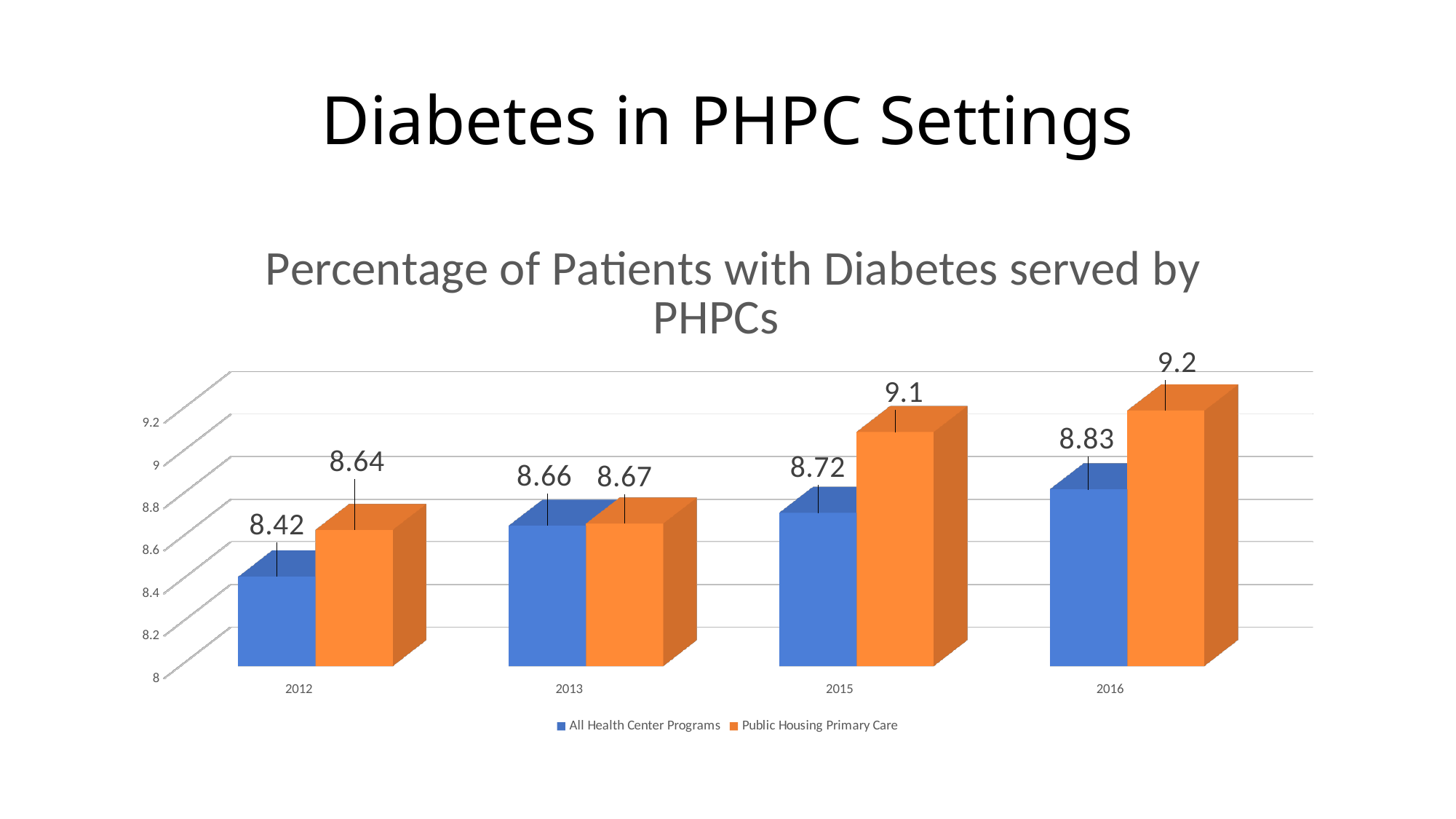
What is the title of the chart? Percentage of Patients with Diabetes served by PHPCs What is the value for Public Housing Primary Care in 2016? 9.2 Do the values for Public Housing Primary Care rise or fall from 2012 to 2016? rise What kind of chart is this? bar chart What is the value for All Health Center Programs in 2012? 8.42 Which is larger in 2016, All Health Center Programs or Public Housing Primary Care? Public Housing Primary Care What is the value for Public Housing Primary Care in 2015? 9.1 What is the difference between Public Housing Primary Care and All Health Center Programs in 2015? 0.38 How many series does the legend list? 2 Which year has the highest value for Public Housing Primary Care? 2016 Which year has the lowest value for All Health Center Programs? 2012 How many years are shown on the x axis? 4